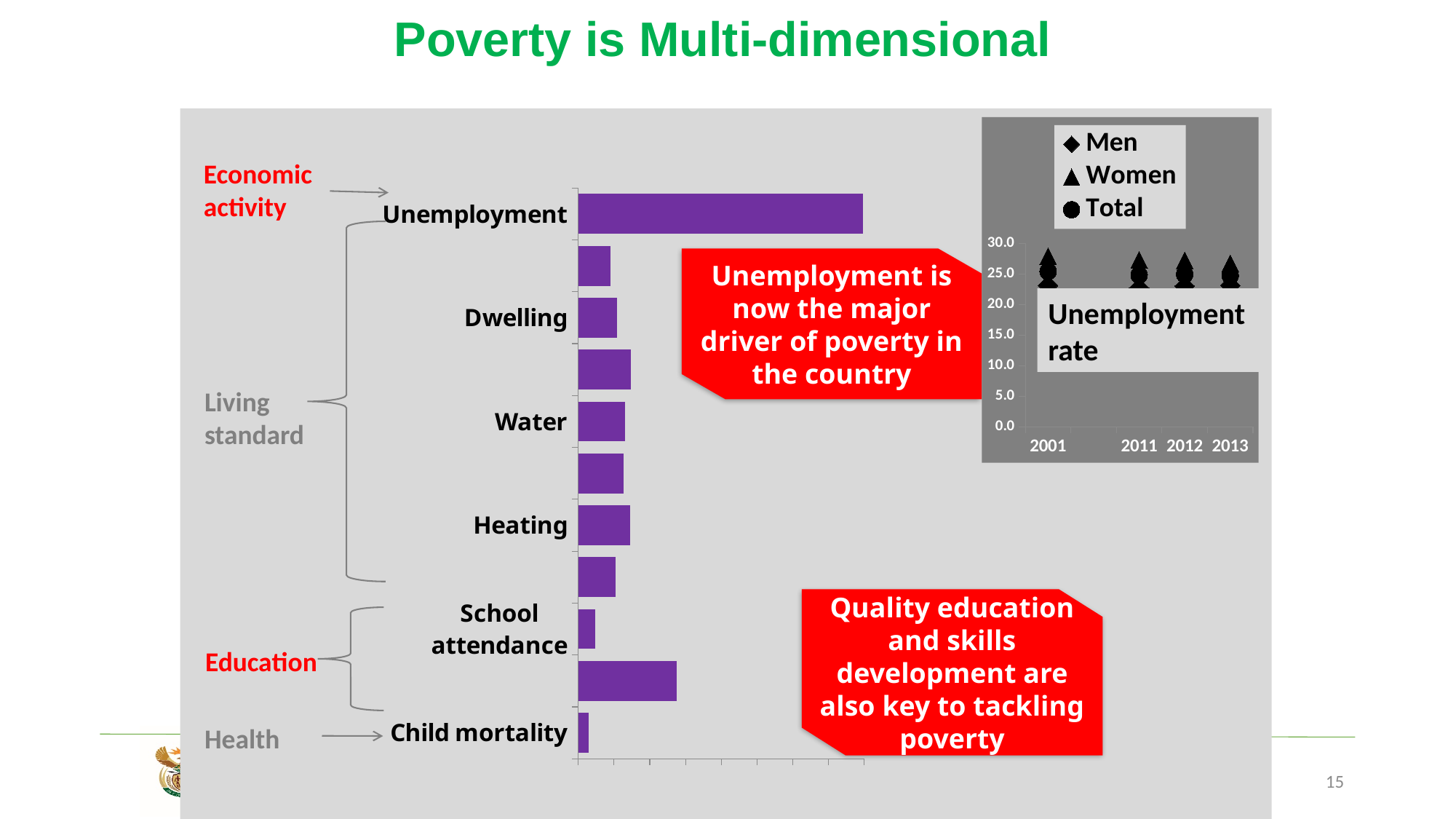
In the bar chart on the left, which has the larger value, Unemployment or Dwelling? Unemployment In the 'Unemployment rate' chart, is the Women value for 2001 greater or less than 30.0? less What kind of chart is the large chart on the left of the slide? bar chart How many years are shown on the x axis of the 'Unemployment rate' chart? 4 In the 'Unemployment rate' chart, is the Total value for 2013 greater or less than 20.0? greater How many bars are plotted in the bar chart on the left? 11 What are the three legend entries in the 'Unemployment rate' chart? Men, Women, Total In the bar chart on the left, which has the larger value, Heating or School attendance? Heating In the bar chart on the left, which labelled category has the shortest bar? Child mortality In the bar chart on the left, which category has the longest bar? Unemployment In the bar chart on the left, which has the larger value, Water or Child mortality? Water How many series does the legend of the 'Unemployment rate' chart list? 3